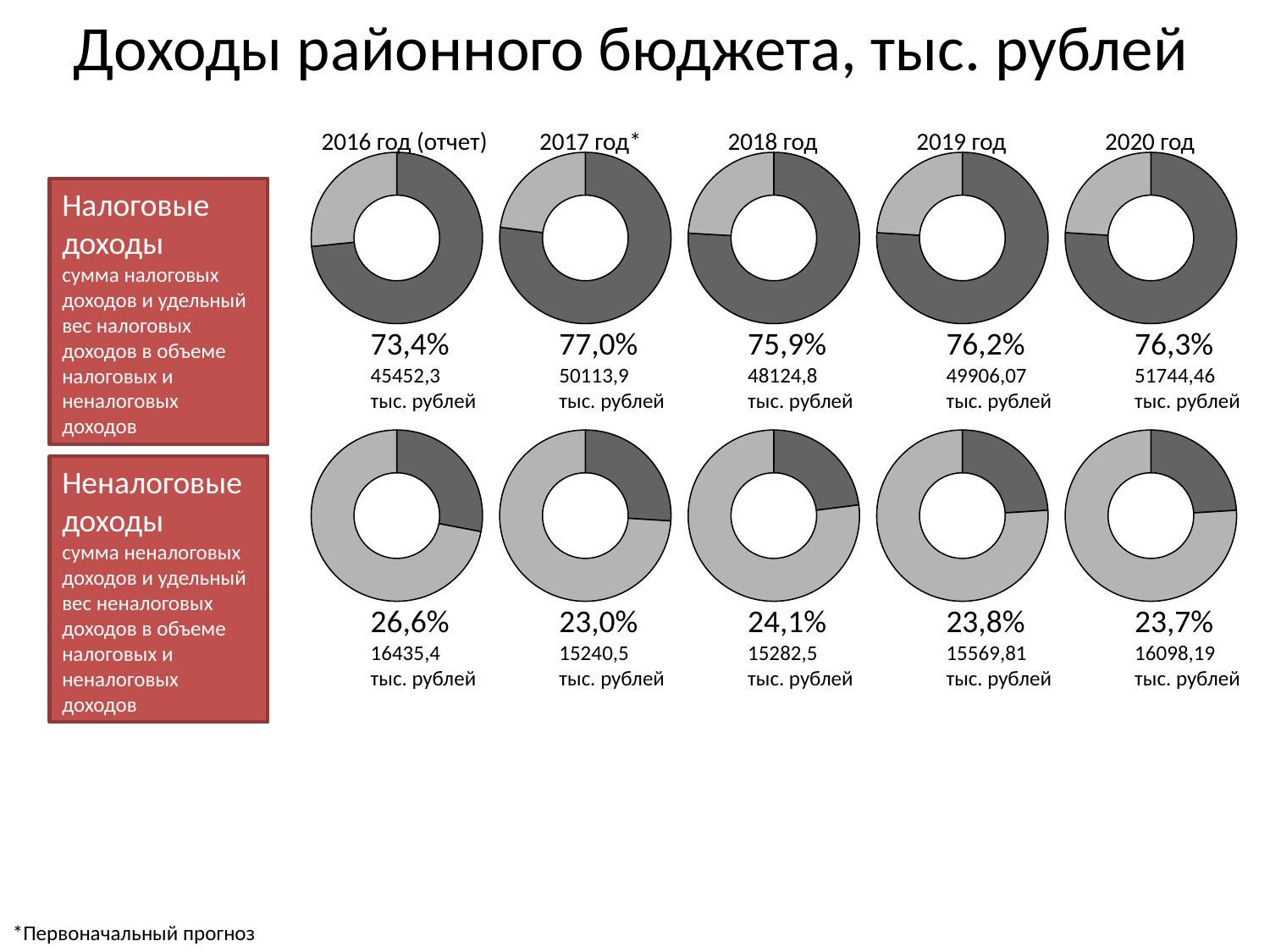
In the top row (Налоговые доходы), do the amounts in тыс. рублей rise or fall from 2018 год to 2020 год? Rise What is the title of the slide? Доходы районного бюджета, тыс. рублей In the top row (Налоговые доходы), which year has the larger amount: 2017 год or 2020 год? 2020 год (51744,46 тыс. рублей) What kind of charts are used on this slide? Pie (donut) charts For 2016 год (отчет), what is the difference between the tax revenue amount (top row) and the non-tax revenue amount (bottom row)? 29016,9 тыс. рублей In the bottom row (Неналоговые доходы), which year has the lowest share of non-tax revenues? 2017 год (23,0%) In the bottom row (Неналоговые доходы), what amount in тыс. рублей is shown for 2019 год? 15569,81 тыс. рублей In the top row (Налоговые доходы), what share is shown for 2017 год? 77,0% How many donut charts are shown on the slide? 10 In the 2016 год (отчет) chart in the top row, what share of the donut does the dark slice (tax revenues) represent? 73,4% In the top row (Налоговые доходы), which year has the highest share of tax revenues? 2017 год (77,0%) In the top row (Налоговые доходы), by how many percentage points does the 2017 share exceed the 2016 share? 3,6 percentage points